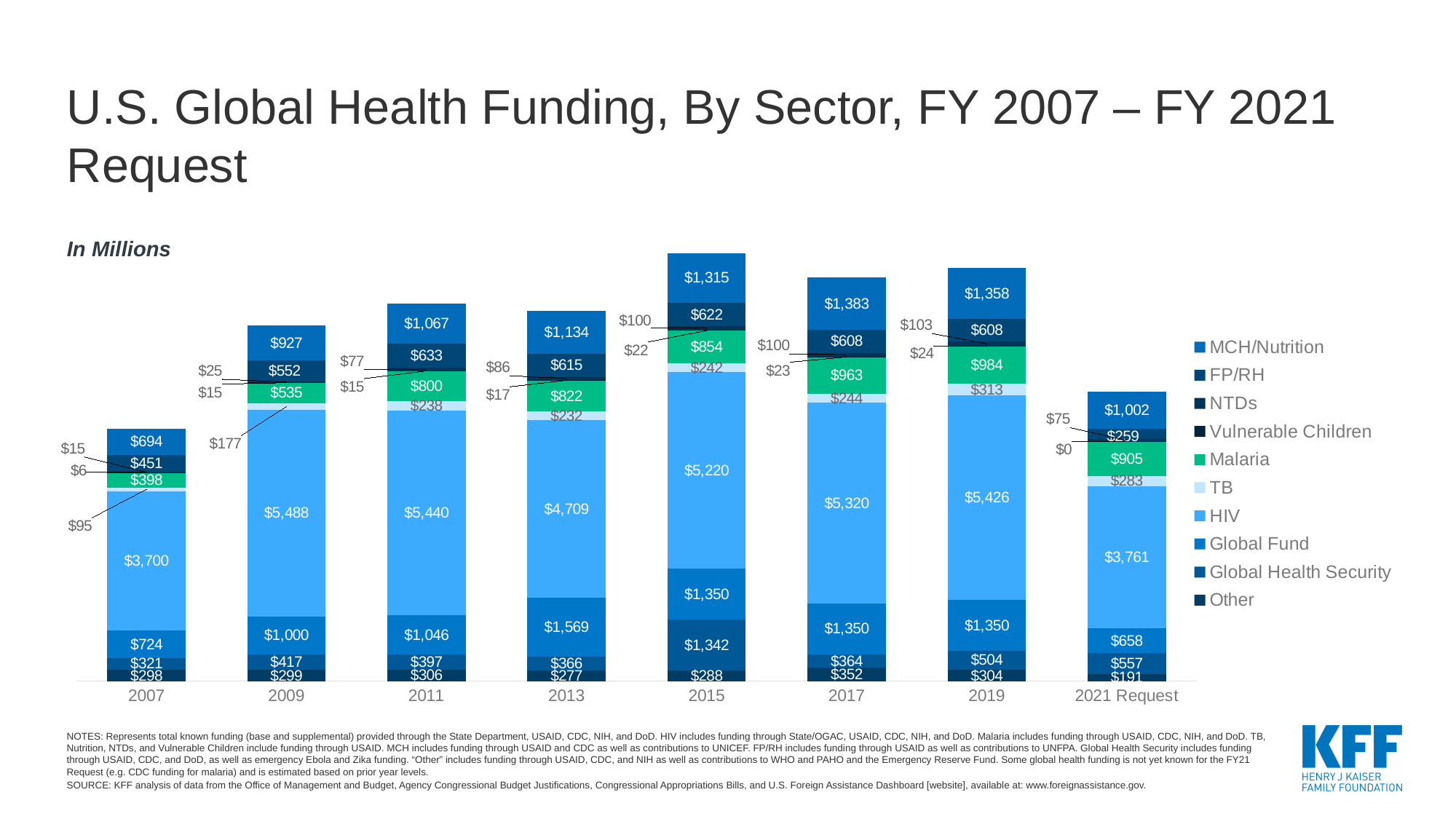
What is the Global Health Security value for 2015? $1,342 What kind of chart is shown on the slide? Stacked bar chart What is the difference between the MCH/Nutrition values for 2017 and 2019? $25 In which year is the HIV segment the largest? 2009 How many series does the legend list? 10 In which year is the HIV segment the smallest? 2007 Does the Malaria value rise or fall from 2013 to 2019? Rise What is the HIV funding value for 2019? $5,426 How many years (bars) are shown on the x axis? 8 What is the Malaria value for the 2021 Request? $905 Which is larger, the Global Health Security value for 2015 or for 2017? 2015 What is the Global Fund value for 2013? $1,569